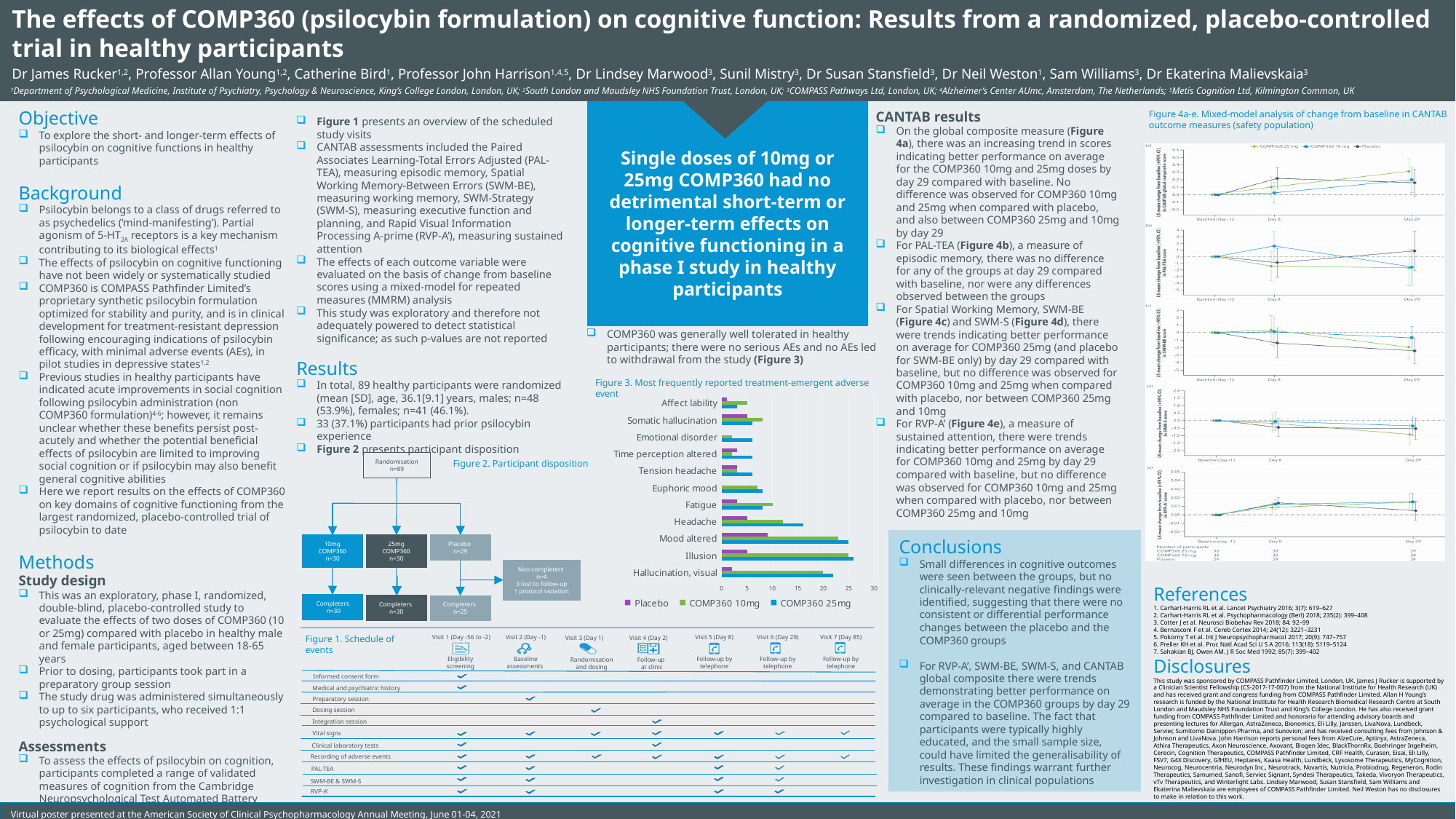
In Figure 3, for Headache, which group has the larger value: COMP360 10mg or COMP360 25mg? COMP360 25mg How many series does the legend of Figure 3 list? 3 What is the highest tick value shown on the horizontal axis of Figure 3? 30 In Figure 3, which adverse event has the highest value for the Placebo group? Mood altered In Figure 3, is the value for Hallucination, visual in the COMP360 25mg group greater or less than 20? greater How many adverse event categories are listed in Figure 3? 11 In Figure 3, for Mood altered, which group has the larger value: Placebo or COMP360 25mg? COMP360 25mg In Figure 3, is the value for Affect lability in the COMP360 25mg group greater or less than 5? less What kind of chart is Figure 3 (most frequently reported treatment-emergent adverse events)? bar chart How many series are plotted in each of the line charts in Figure 4a-e? 3 What are the three series named in the legend of Figure 3? Placebo, COMP360 10mg, COMP360 25mg In Figure 3, is the value for Headache in the COMP360 25mg group greater or less than 10? greater